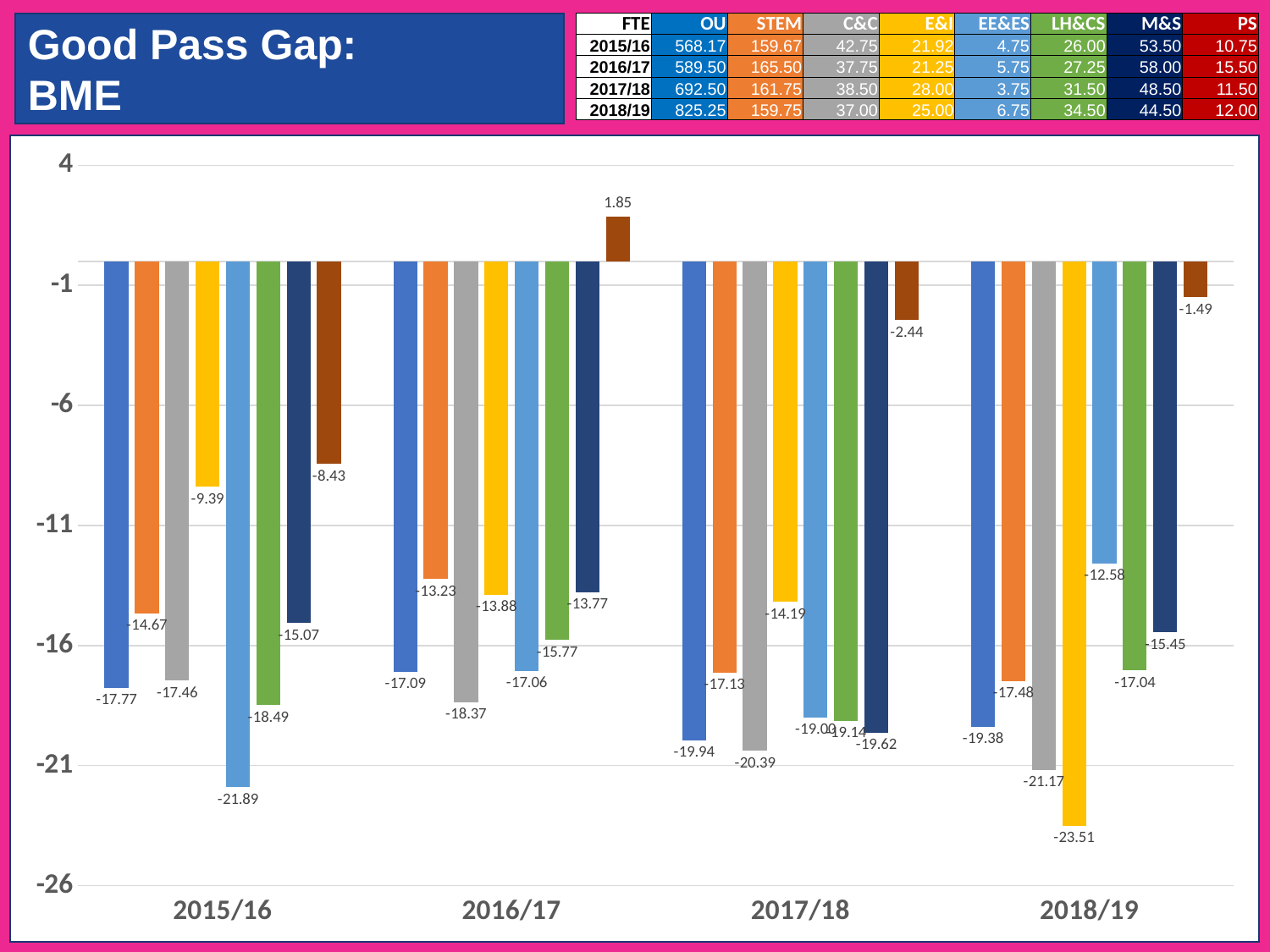
What is the difference between the highest value (-8.43) and the lowest value (-21.89) in the 2015/16 group? 13.46 What is the lowest value labelled in the 2017/18 group of the chart? -20.39 What is the lowest value labelled in the 2015/16 group of the chart? -21.89 How many academic year groups are shown along the x axis of the chart? 4 What is the lowest value labelled in the 2018/19 group of the chart? -23.51 What is the only positive value labelled on the chart, and in which year group does it appear? 1.85, in 2016/17 What is the title shown on the slide? Good Pass Gap: BME How many bars are plotted in each academic year group on the chart? 8 Which is larger: the first (blue) bar in 2015/16 at -17.77 or the first (blue) bar in 2016/17 at -17.09? 2016/17 (-17.09) What is the highest (least negative) value labelled in the 2015/16 group of the chart? -8.43 Is the value of the brown (last) bar in the 2017/18 group greater or less than -6? greater What kind of chart is shown on the slide? bar chart